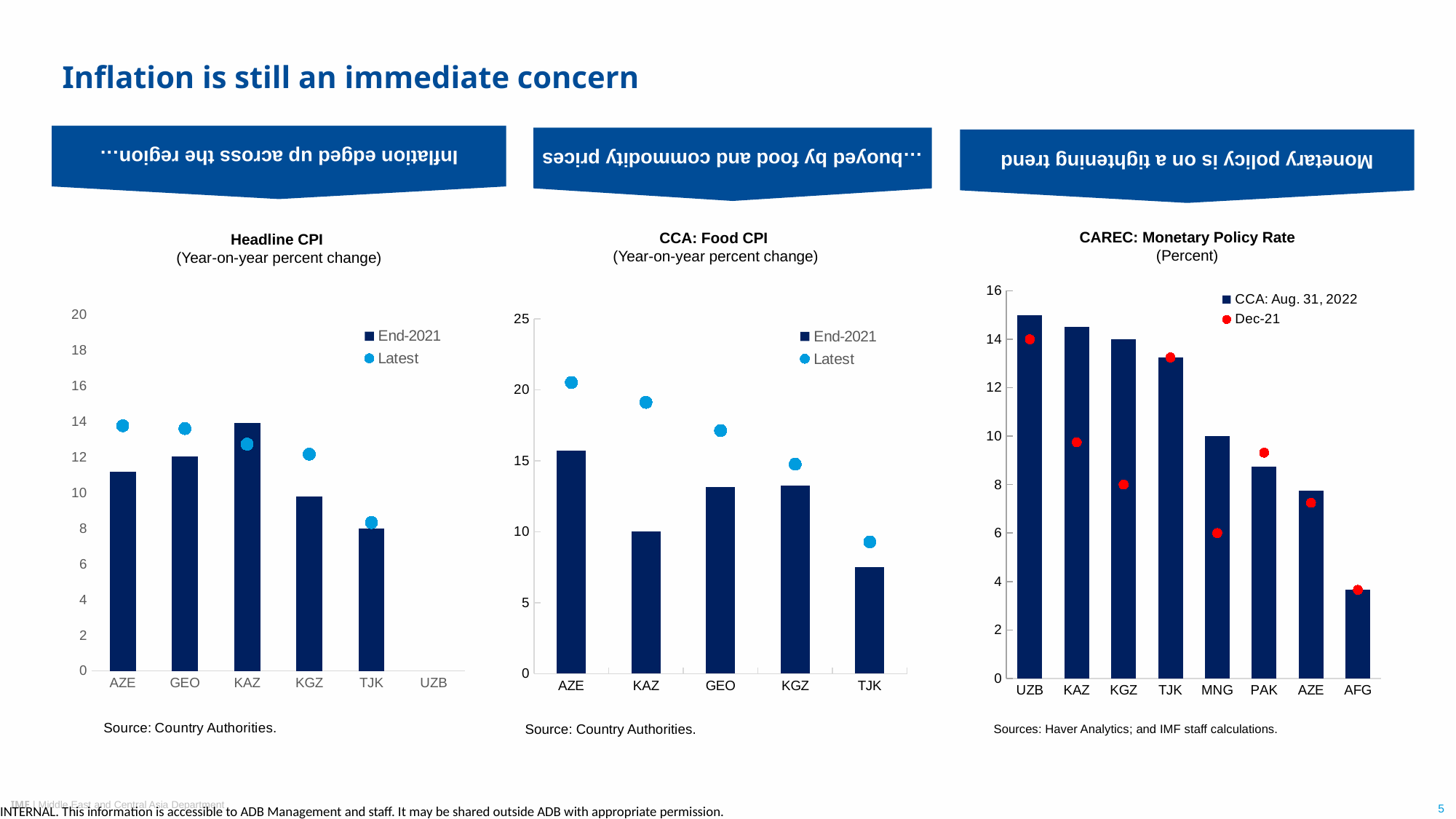
In the CAREC: Monetary Policy Rate chart, which country has the highest CCA: Aug. 31, 2022 bar? UZB In the CAREC: Monetary Policy Rate chart, is the CCA: Aug. 31, 2022 value for PAK greater or less than 10? less In the CAREC: Monetary Policy Rate chart, which country has the lowest CCA: Aug. 31, 2022 bar? AFG In the CCA: Food CPI chart, is the End-2021 value for TJK greater or less than 10? less In the Headline CPI chart, how many series does the legend list? 2 In the CCA: Food CPI chart, which country has the highest End-2021 bar? AZE In the Headline CPI chart, is the End-2021 value for AZE greater or less than 10? greater In the Headline CPI chart, which country has the highest End-2021 bar? KAZ In the CCA: Food CPI chart, how many countries are shown on the x axis? 5 In the CAREC: Monetary Policy Rate chart, how many countries are shown on the x axis? 8 In the CCA: Food CPI chart, which country has the lowest End-2021 bar? TJK